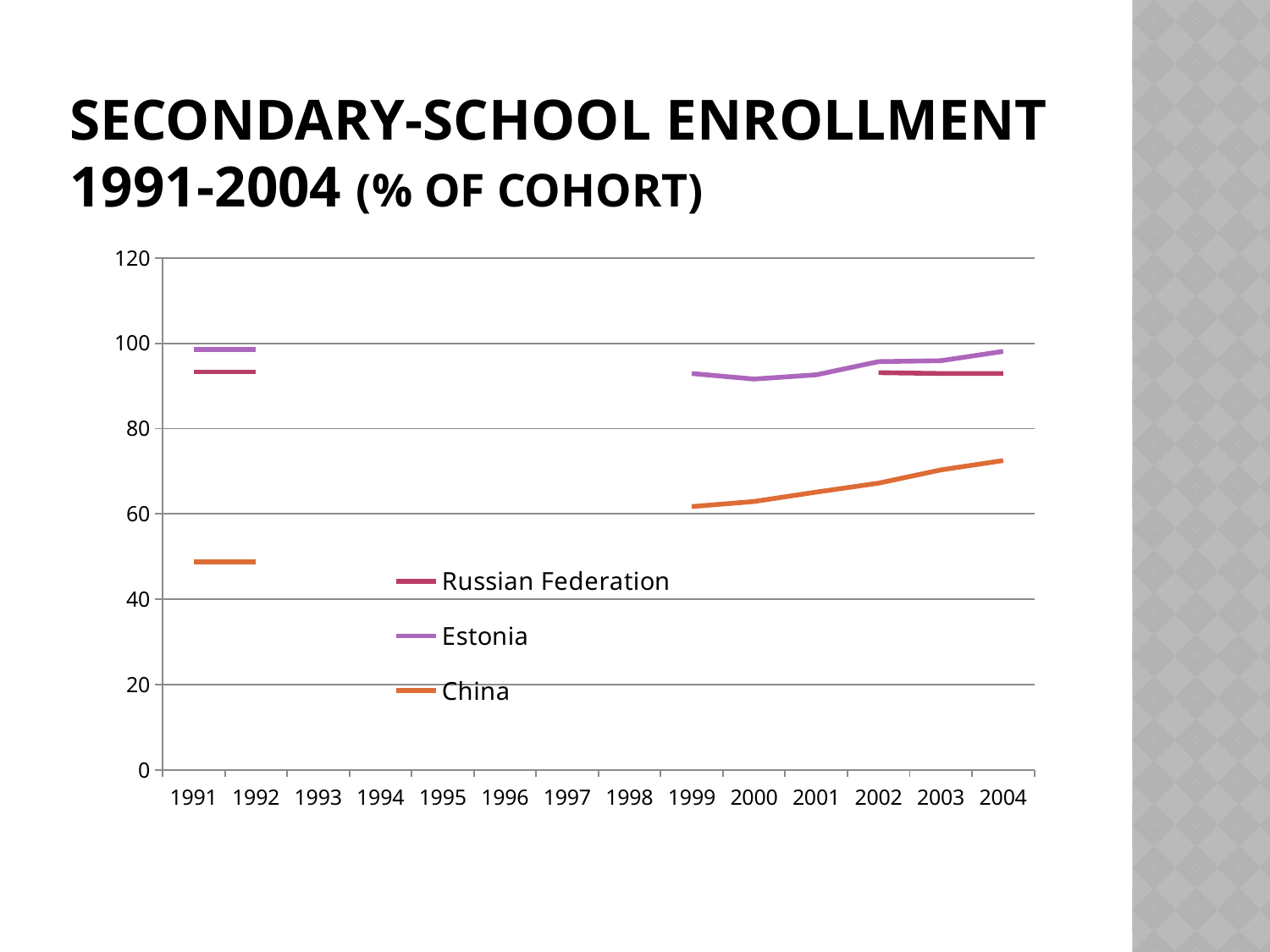
How many years are labelled on the x axis? 14 Is the value for China in 1991 greater or less than 60? less Is the value for the Russian Federation in 2004 greater or less than 80? greater How many series does the legend list? 3 Which series has the lowest value in 2004? China Is the value for Estonia in 1991 greater or less than 80? greater What kind of chart is shown on the slide? line chart Which is larger in 1991, the value for Estonia or the value for the Russian Federation? Estonia Does the value for China rise or fall from 1999 to 2004? rise Which series is drawn in orange? China What is the title of the chart? SECONDARY-SCHOOL ENROLLMENT 1991-2004 (% OF COHORT)